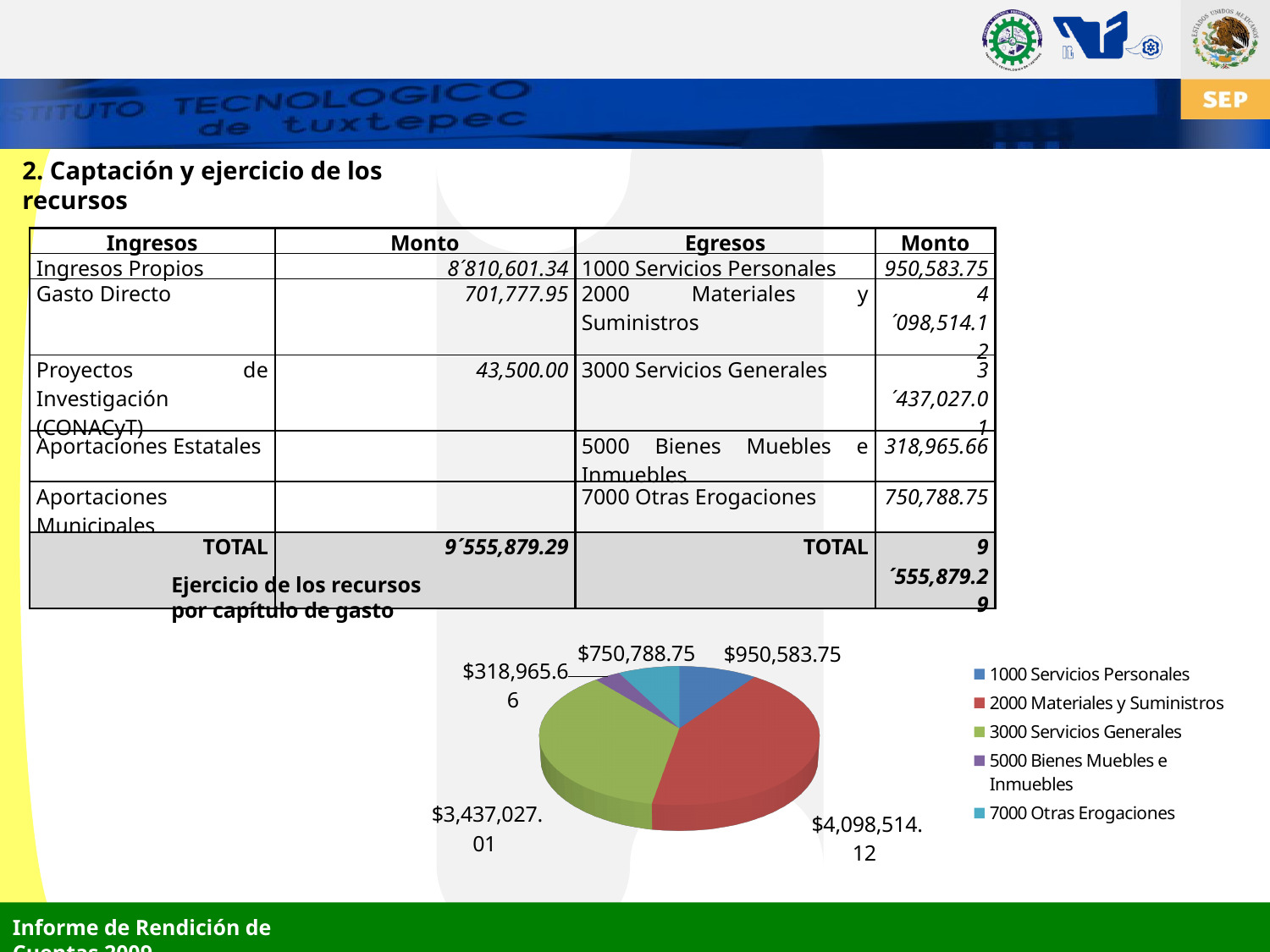
Which category has the largest slice in the pie chart? 2000 Materiales y Suministros What is the value for 1000 Servicios Personales in the pie chart? $950,583.75 How many categories does the legend of the pie chart list? 5 What kind of chart is shown on the slide? pie chart What is the value for 5000 Bienes Muebles e Inmuebles in the pie chart? $318,965.66 Which category has the smallest slice in the pie chart? 5000 Bienes Muebles e Inmuebles Which is larger, the value for 3000 Servicios Generales or the value for 1000 Servicios Personales? 3000 Servicios Generales What is the difference between the values for 2000 Materiales y Suministros and 3000 Servicios Generales? $661,487.11 What is the difference between the values for 1000 Servicios Personales and 7000 Otras Erogaciones? $199,795.00 What is the value for 7000 Otras Erogaciones in the pie chart? $750,788.75 What is the value for 2000 Materiales y Suministros in the pie chart? $4,098,514.12 What is the title of the pie chart? Ejercicio de los recursos por capítulo de gasto